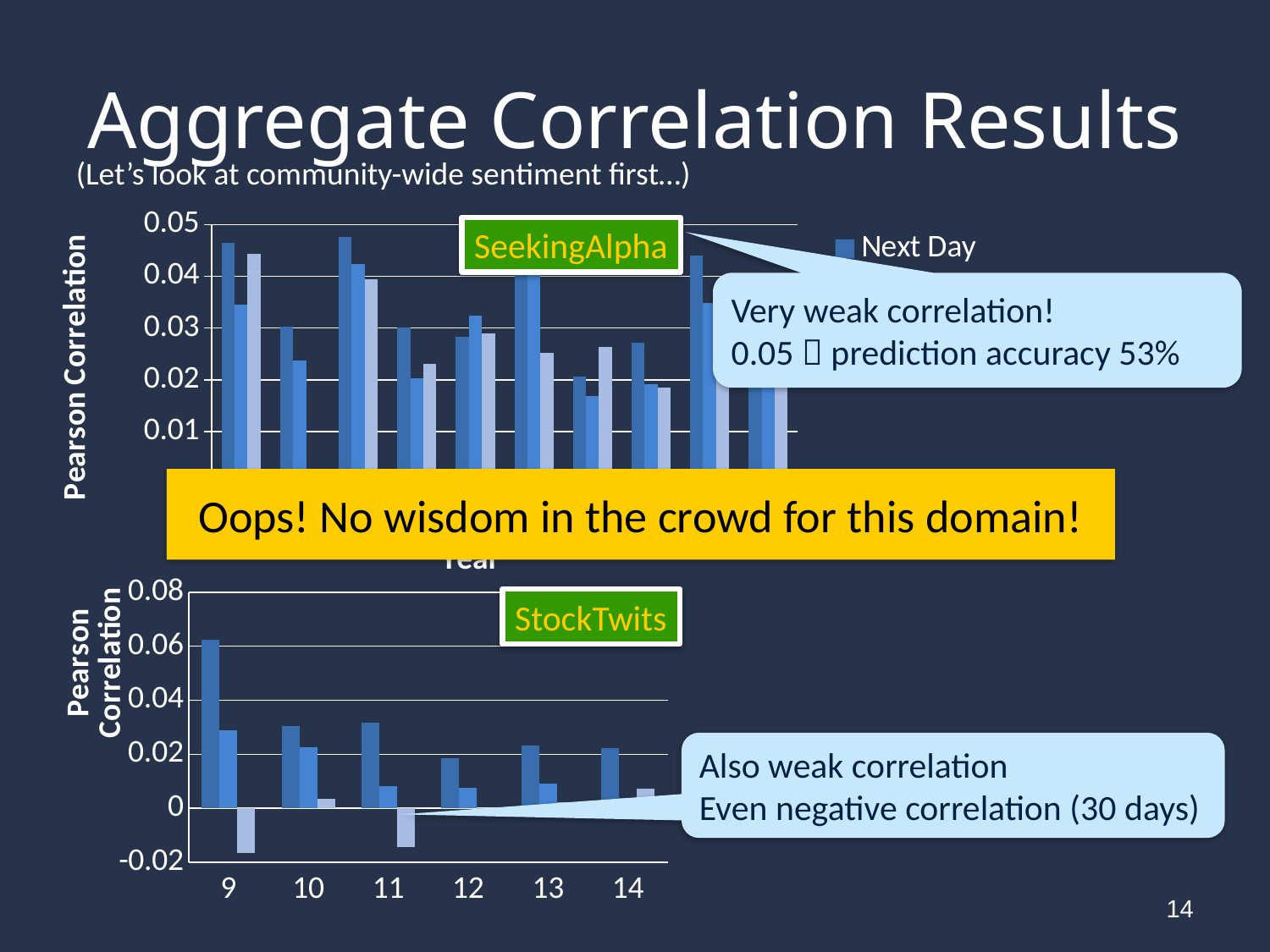
What is the highest value shown on the y axis of the SeekingAlpha chart? 0.05 In the StockTwits chart, is the light blue bar for year 9 greater or less than 0? less In the StockTwits chart, which year has the tallest dark blue bar? 9 In the StockTwits chart, is the dark blue bar for year 9 greater or less than 0.04? greater In the StockTwits chart, is the dark blue bar for year 10 greater or less than 0.02? greater What kind of chart is the StockTwits chart at the bottom of the slide? Bar chart How many year categories are shown on the x axis of the StockTwits chart? 6 What is the y-axis label of the StockTwits chart? Pearson Correlation In the StockTwits chart, which is larger: the dark blue bar for year 9 or the dark blue bar for year 14? Year 9